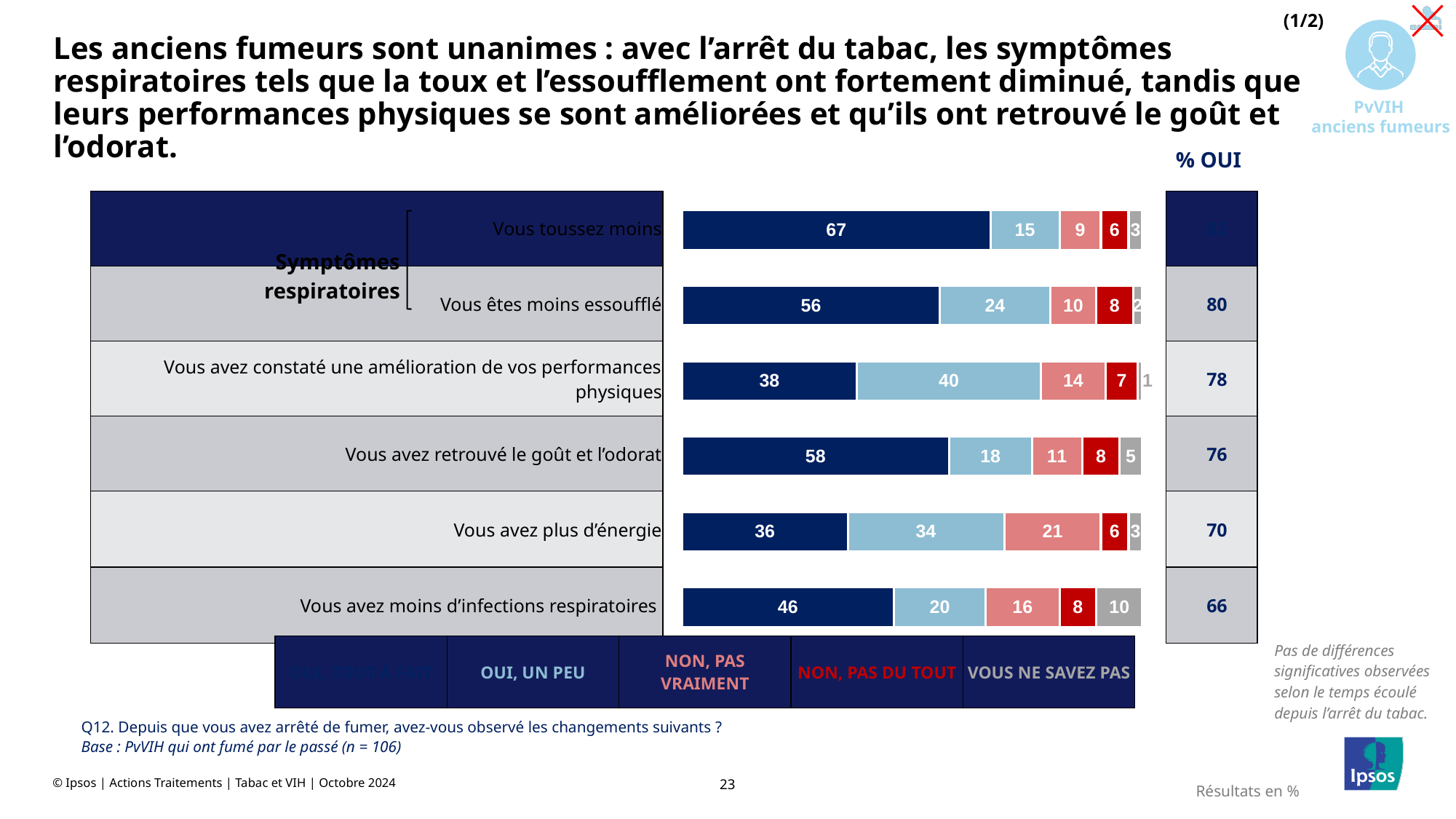
How many response categories does the legend list? 5 What is the "VOUS NE SAVEZ PAS" value for "Vous avez moins d'infections respiratoires"? 10 Which statement has the lowest % OUI value? Vous avez moins d'infections respiratoires What is the % OUI value for "Vous êtes moins essoufflé"? 80 Which legend entry is shown in red? NON, PAS DU TOUT What kind of chart is shown on the slide? stacked bar chart Which statement has the highest "OUI, TOUT À FAIT" value? Vous toussez moins What is the "OUI, UN PEU" value for "Vous avez constaté une amélioration de vos performances physiques"? 40 Which is larger: the "NON, PAS VRAIMENT" value for "Vous avez plus d'énergie" or for "Vous avez moins d'infections respiratoires"? Vous avez plus d'énergie What is the "OUI, TOUT À FAIT" value for "Vous toussez moins"? 67 How many statements (categories) are plotted in the chart? 6 What is the difference between the "OUI, TOUT À FAIT" values for "Vous avez retrouvé le goût et l'odorat" and "Vous avez plus d'énergie"? 22